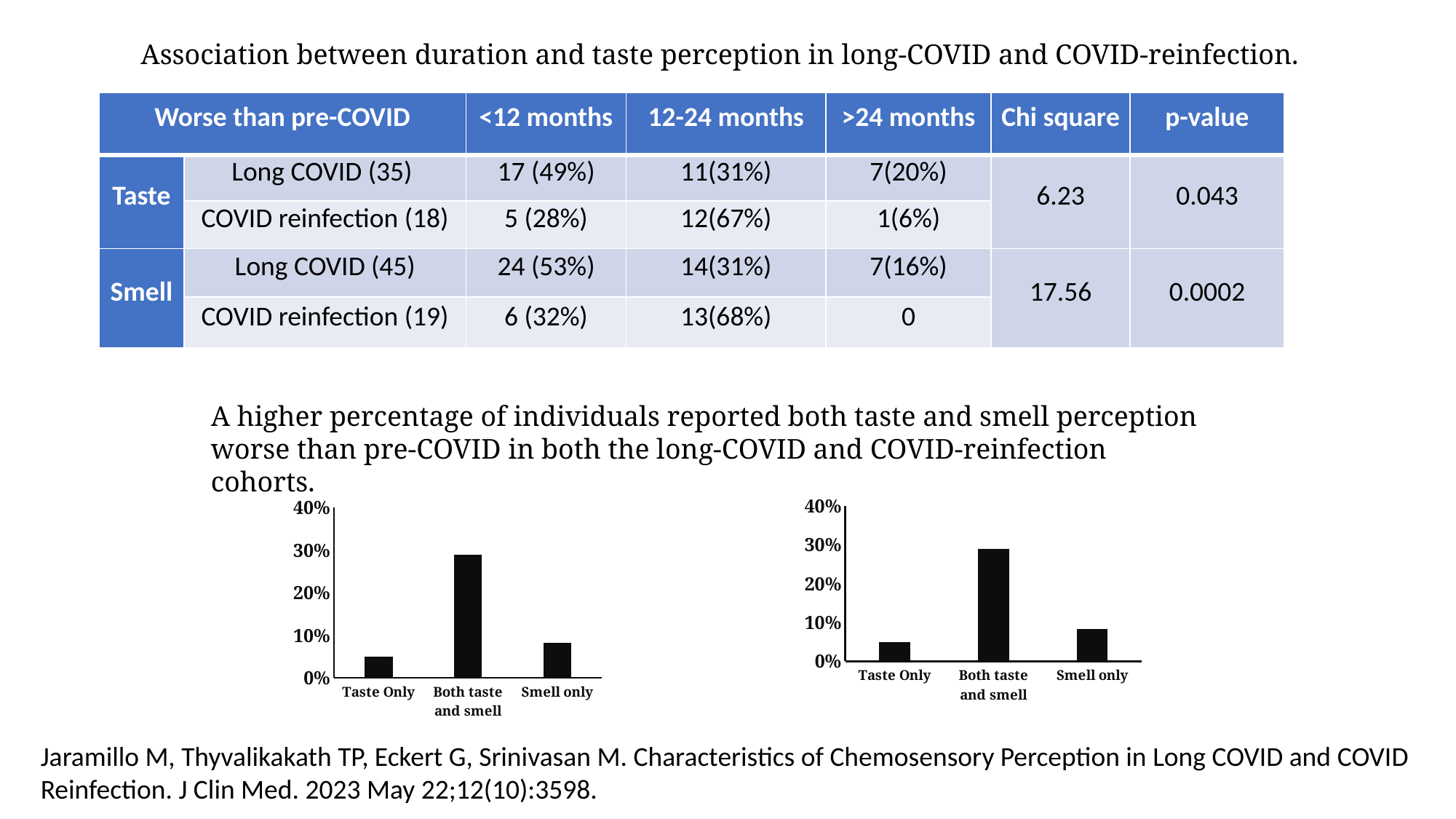
In the right chart, which category has the lowest bar? Taste Only In the right chart, is the value for Smell only greater or less than 10%? less In the left chart, is the value for Both taste and smell greater or less than 20%? greater What kind of chart is the left chart on the slide? bar chart In the left chart, which category has the highest bar? Both taste and smell In the left chart, which category has the lowest bar? Taste Only In the left chart, which is larger, the value for Both taste and smell or the value for Smell only? Both taste and smell What is the highest tick value shown on the y axis of the right chart? 40% In the right chart, which is larger, the value for Smell only or the value for Taste Only? Smell only In the right chart, which category has the highest bar? Both taste and smell How many categories are shown on the x axis of the left chart? 3 In the left chart, is the value for Taste Only greater or less than 10%? less